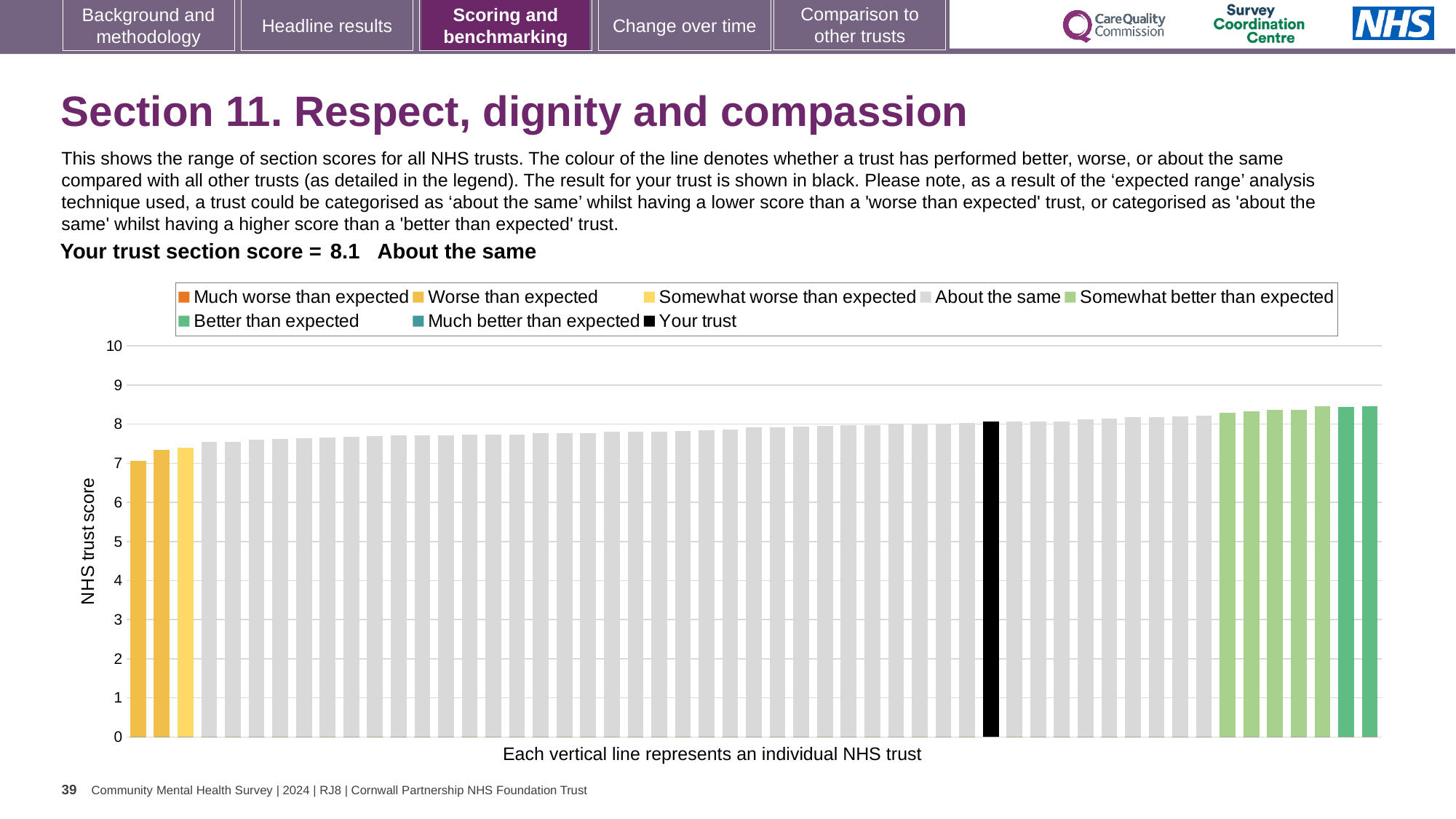
Is the value of the leftmost (lowest) bar greater or less than 8? less Is the value of the rightmost (highest) bar greater or less than 8? greater What is the label on the vertical axis of the chart? NHS trust score What colour is the bar representing your trust? Black Is the value of the black 'Your trust' bar greater or less than 7? greater Do the bar values rise or fall moving from left to right along the x axis? Rise What is the section score for your trust shown on the slide? 8.1 What kind of chart is shown on the slide? Bar chart How many entries does the chart legend list? 8 Which performance category is your trust placed in for this section? About the same Which is larger: the value of the black 'Your trust' bar or the value of the leftmost bar? Your trust Which is larger: the value of the rightmost bar or the value of the black 'Your trust' bar? The rightmost bar